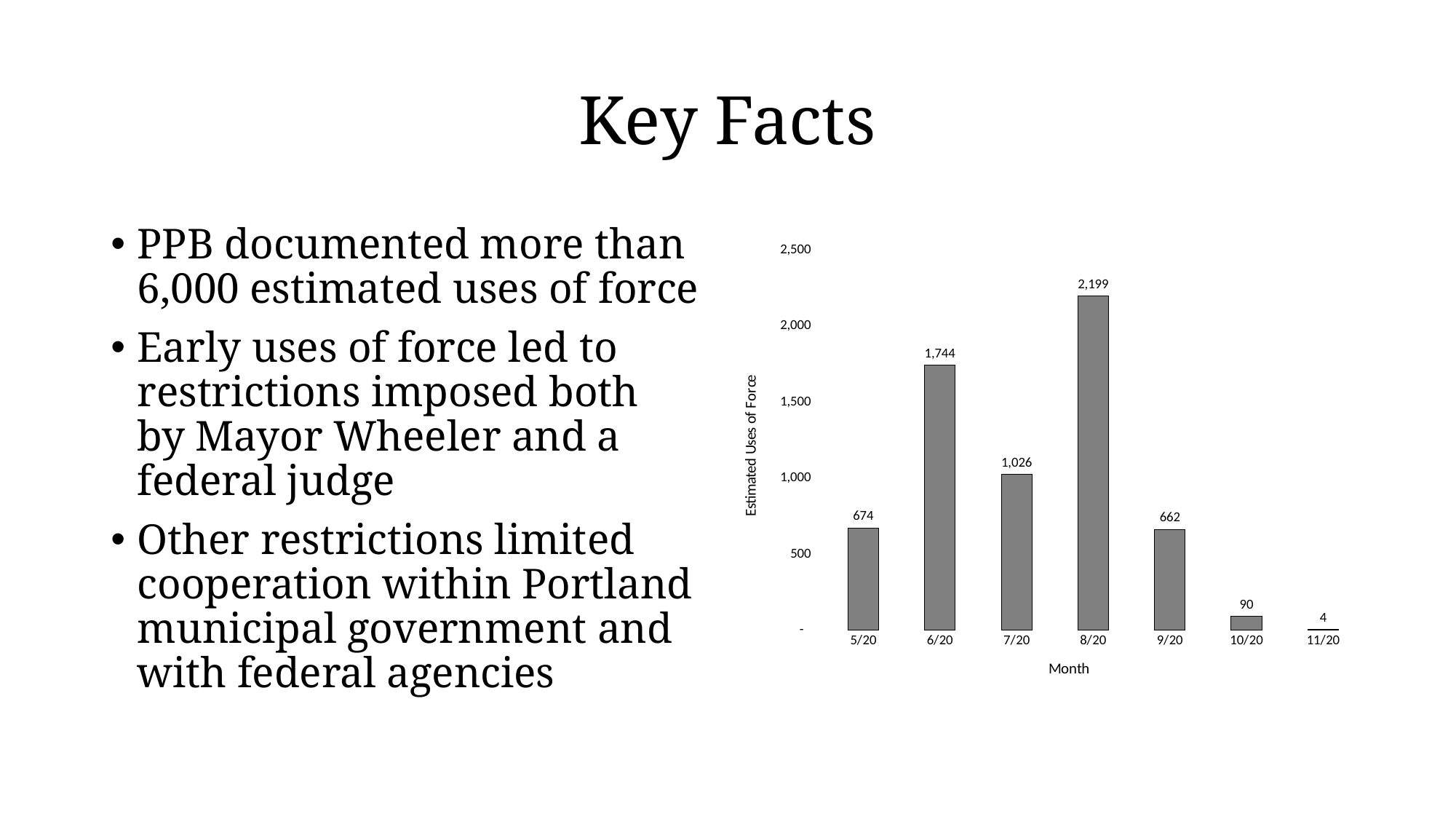
What is the estimated number of uses of force for 8/20? 2,199 What is the difference in estimated uses of force between 8/20 and 6/20? 455 Which month has the lowest estimated uses of force? 11/20 Is the value for 6/20 greater or less than 1,500? greater Which month has more estimated uses of force, 5/20 or 9/20? 5/20 What is the label of the vertical axis of the chart? Estimated Uses of Force How many months are shown on the x axis of the chart? 7 What is the difference in estimated uses of force between 7/20 and 9/20? 364 What is the estimated number of uses of force for 5/20? 674 Which month has the highest estimated uses of force? 8/20 What is the estimated number of uses of force for 10/20? 90 What kind of chart is shown on the slide? Bar chart